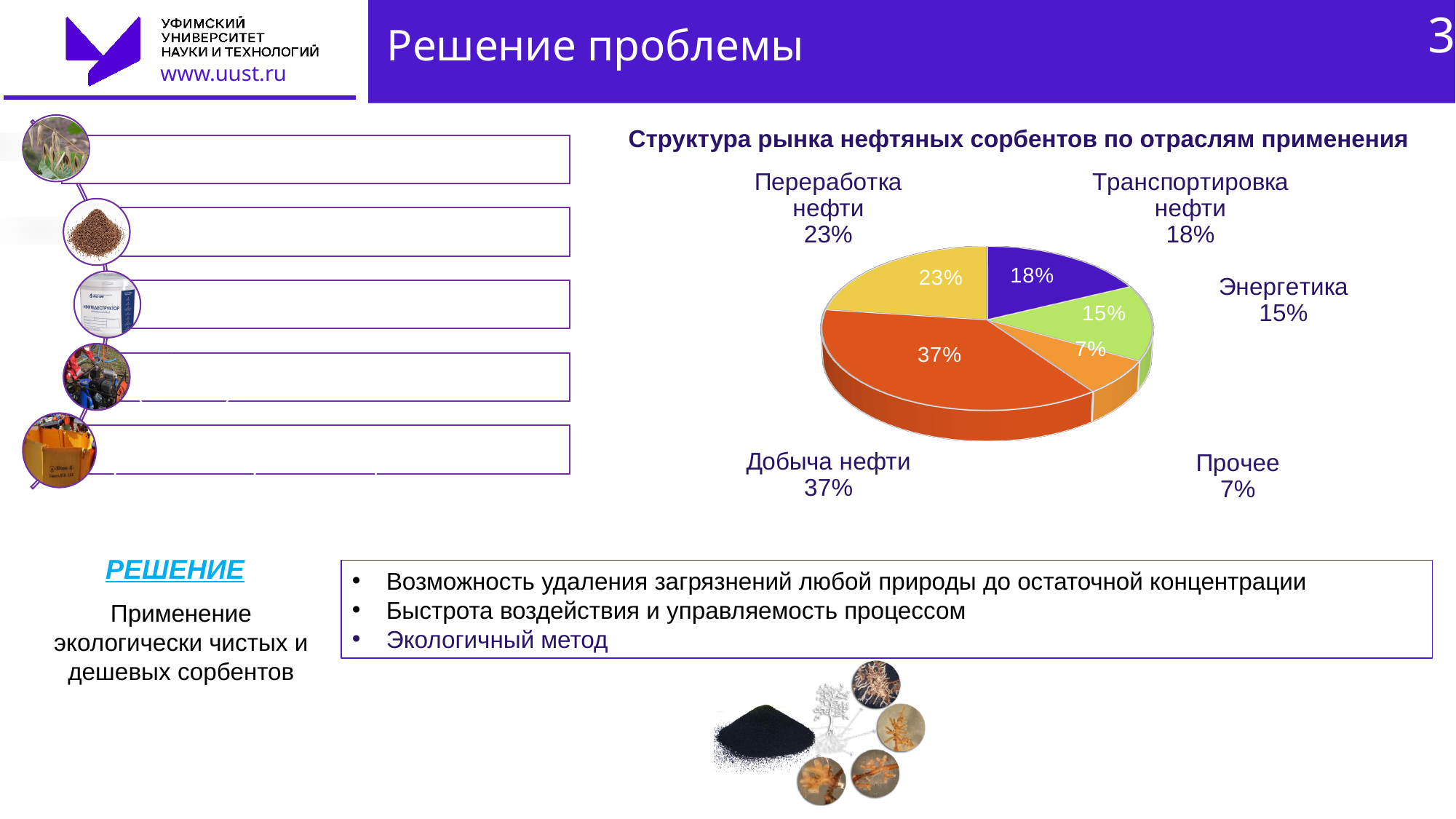
What colour is the slice for Добыча нефти? Orange What is the difference in share between Добыча нефти and Переработка нефти? 14% What share of the oil sorbent market does Прочее hold? 7% What type of chart is used to show the structure of the oil sorbent market? Pie chart Which has a larger share, Транспортировка нефти or Энергетика? Транспортировка нефти What share of the oil sorbent market does Добыча нефти hold? 37% What share of the oil sorbent market does Энергетика hold? 15% What share of the oil sorbent market does Транспортировка нефти hold? 18% Which sector has the smallest share of the oil sorbent market? Прочее Which sector has the largest share of the oil sorbent market? Добыча нефти What is the title of the chart? Структура рынка нефтяных сорбентов по отраслям применения How many sectors are shown in the pie chart? 5